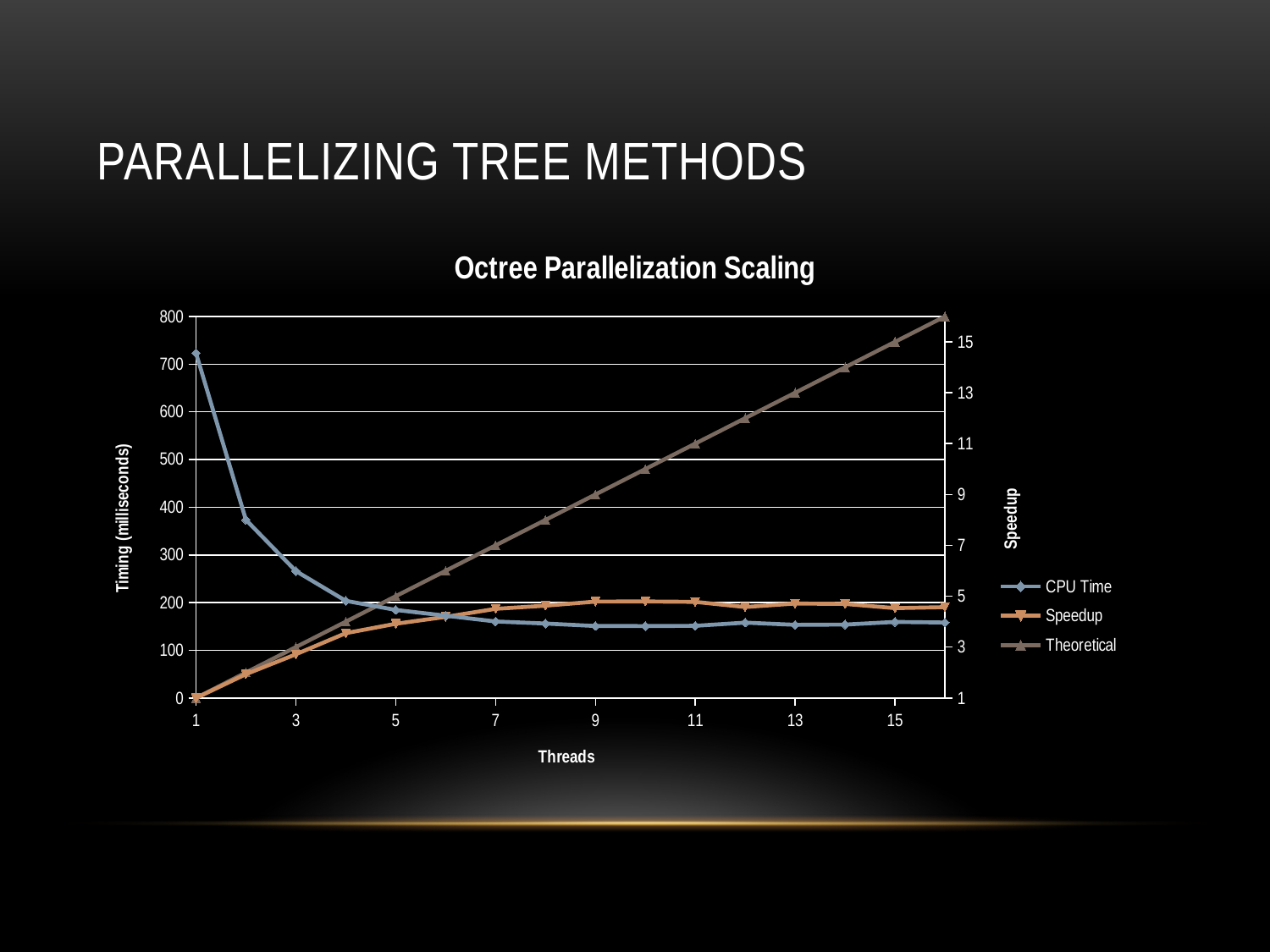
What is the label of the x axis? Threads Is the CPU Time value at 1 thread greater or less than 600 milliseconds? greater What is the Theoretical speedup value at 13 threads? 13 Does the Theoretical series rise or fall as the number of threads increases? rise At which number of threads is the CPU Time highest? 1 What is the title of the chart? Octree Parallelization Scaling Does the CPU Time series rise or fall as the number of threads increases? fall What kind of chart is shown on the slide? line chart How many series does the legend list? 3 At 16 threads, which is larger: the Theoretical speedup or the measured Speedup? Theoretical Is the CPU Time value at 16 threads greater or less than 200 milliseconds? less What is the Theoretical speedup value at 5 threads? 5